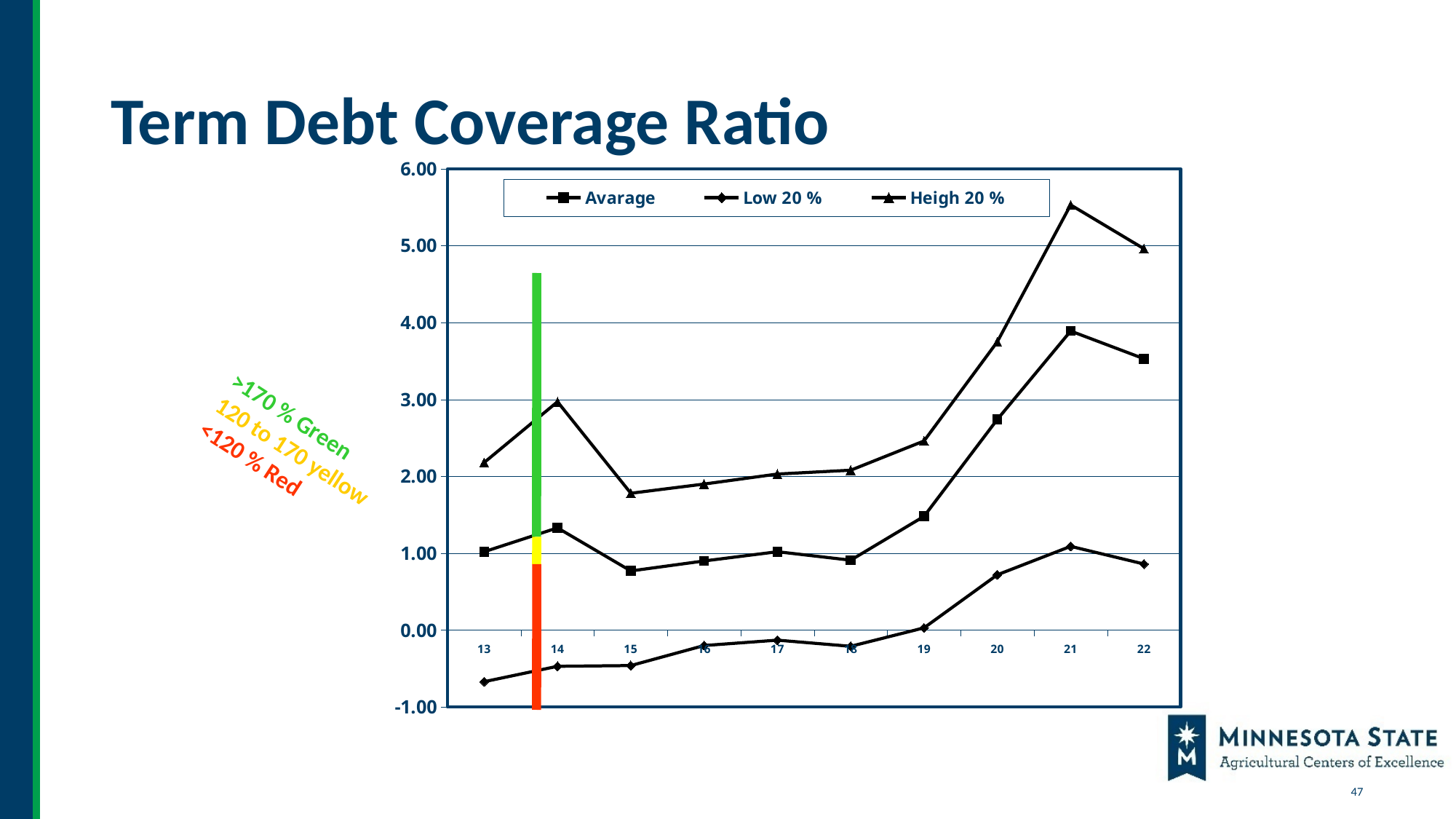
Is the Avarage value for year 20 greater or less than 2.00? greater Is the Low 20 % value for year 13 greater or less than 0.00? less What kind of chart is shown on the slide? line chart Does the Low 20 % series rise or fall from year 13 to year 21? rise Is the Heigh 20 % value for year 15 greater or less than 2.00? less What is the title of the chart on the slide? Term Debt Coverage Ratio Which is larger for the Heigh 20 % series: the value for year 14 or year 15? year 14 How many years are plotted along the x axis? 10 In which year is the Low 20 % series at its lowest value? 13 How many series does the chart legend list? 3 In which year does the Heigh 20 % series reach its highest value? 21